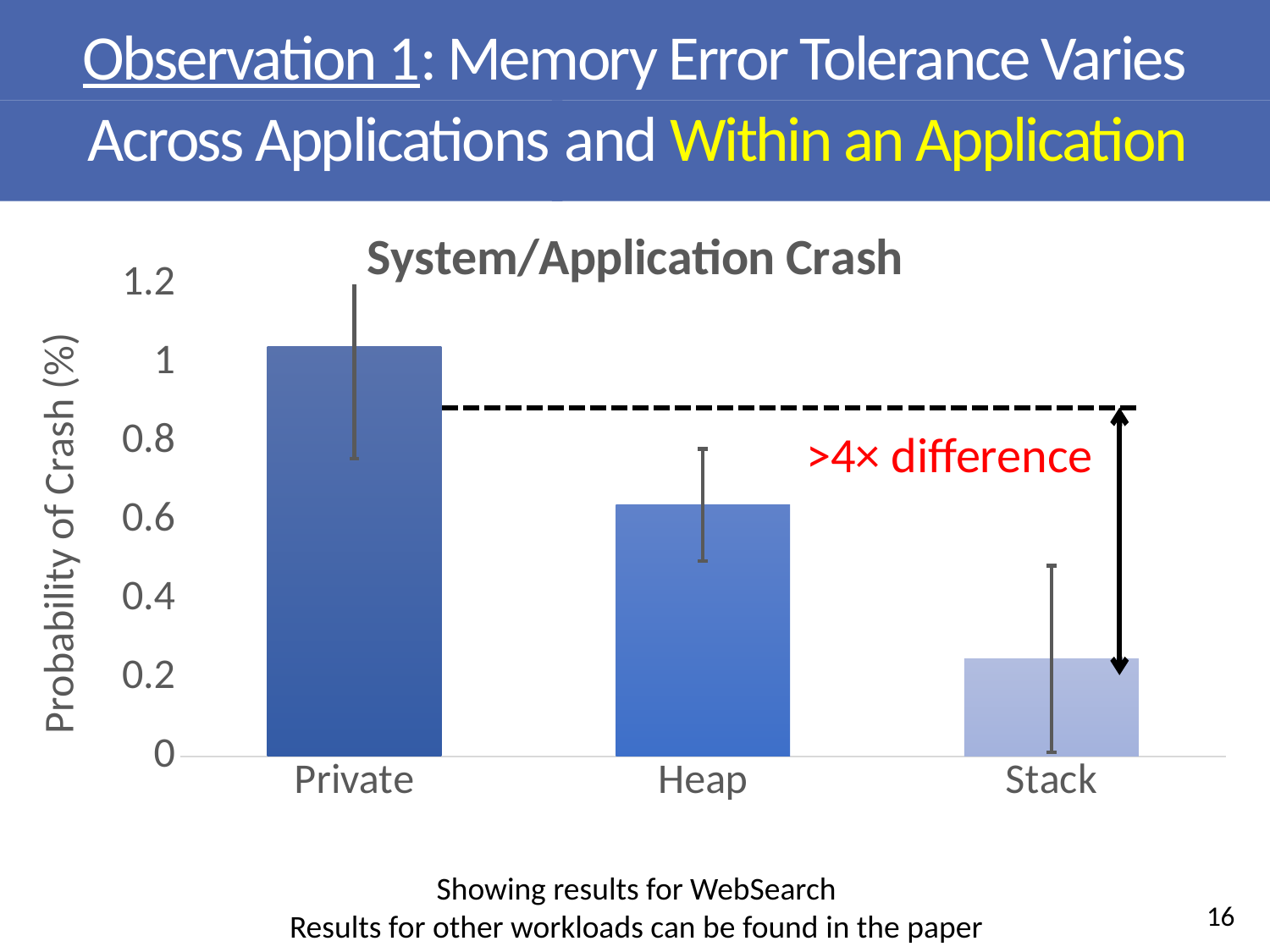
Which category has the highest probability of crash? Private Do the bar values rise or fall from Private to Stack along the x-axis? fall Is the value for Stack greater or less than 0.4? less Which category has the lowest probability of crash? Stack What is the label of the y-axis? Probability of Crash (%) Which has a higher probability of crash, Private or Heap? Private How many categories are shown on the x-axis? 3 Is the value for Private greater or less than 0.8? greater What type of chart is shown on the slide? bar chart Is the value for Heap greater or less than 0.8? less What is the title of the chart? System/Application Crash Which has a higher probability of crash, Heap or Stack? Heap